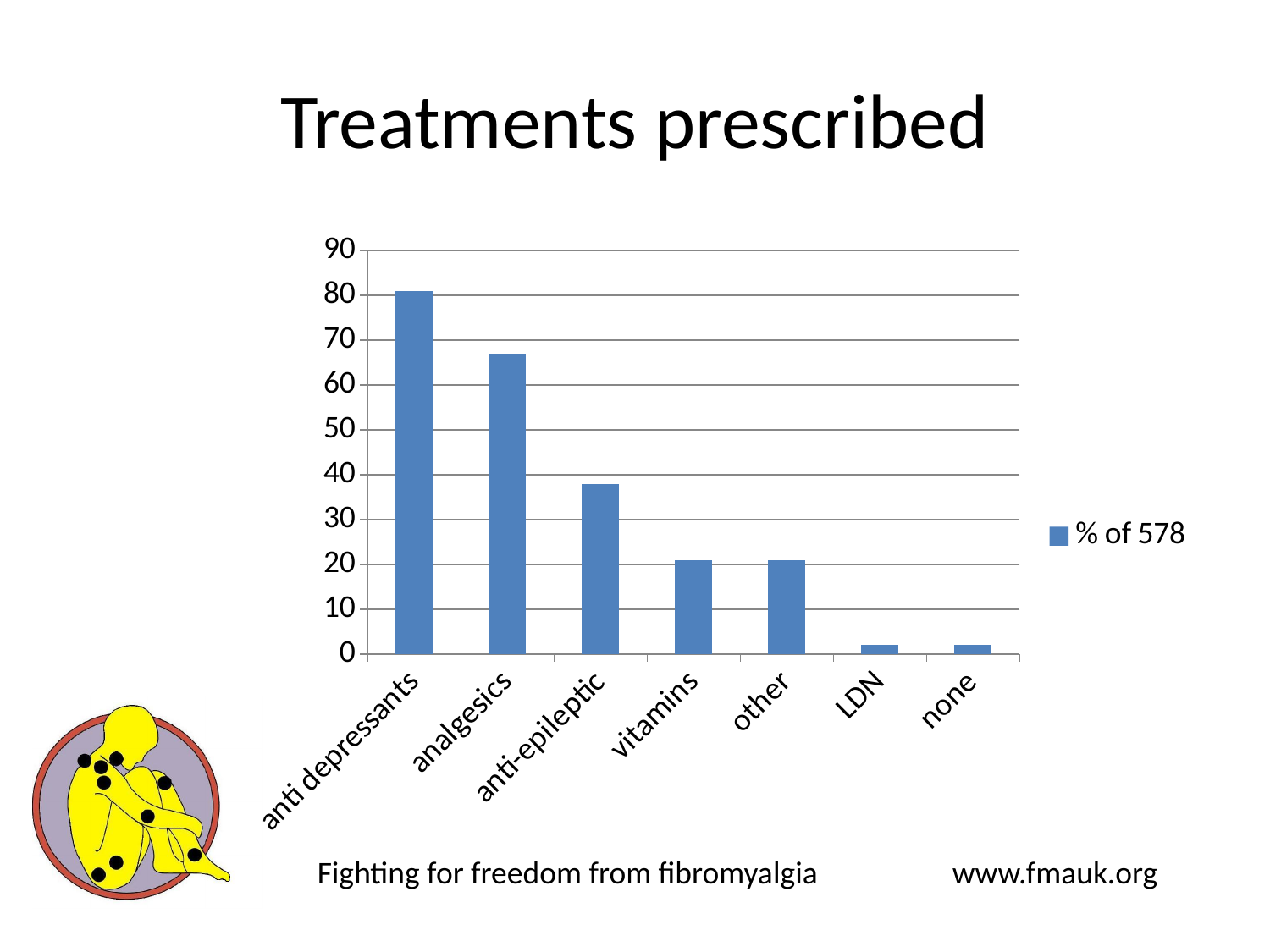
Is the value for analgesics greater or less than 70? less How many treatment categories are shown on the x axis? 7 What is the title of the chart? Treatments prescribed Which is larger, the value for analgesics or the value for anti-epileptic? analgesics How many series does the legend list? 1 What kind of chart is shown on the slide? bar chart Is the value for LDN greater or less than 10? less What is the legend entry for the series? % of 578 Is the value for anti-epileptic greater or less than 30? greater Which treatment category has the highest value? anti depressants